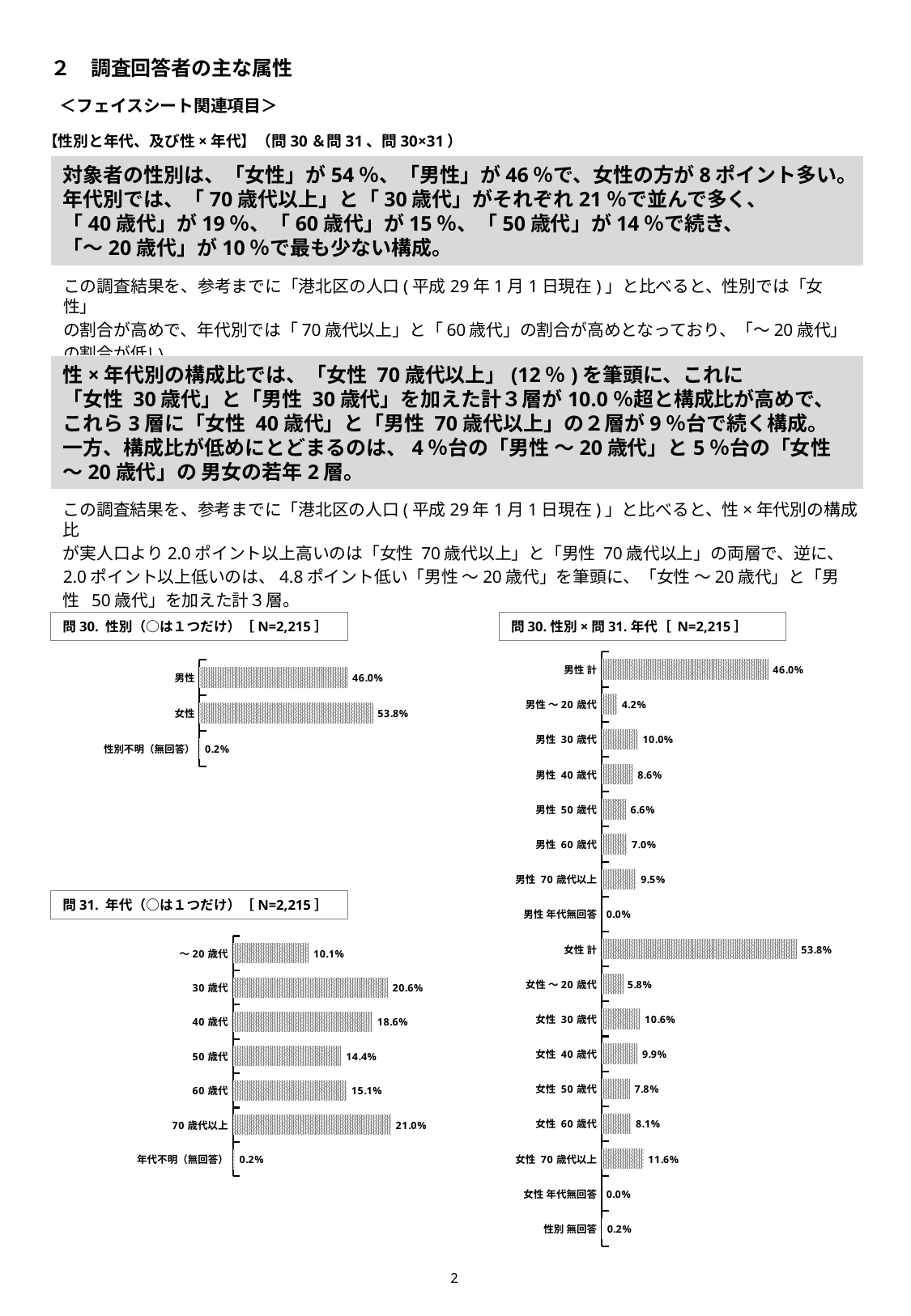
In the 問30. 性別 chart (top left), what is the value for 女性? 53.8% In the 問30. 性別 chart (top left), what is the value for 男性? 46.0% In the 問31. 年代 chart (bottom left), how many categories are plotted? 7 In the 問30. 性別 × 問31. 年代 chart (right), what is the difference between 女性 30歳代 and 男性 30歳代? 0.6 percentage points In the 問30. 性別 × 問31. 年代 chart (right), which is larger, 男性 40歳代 or 女性 40歳代? 女性 40歳代 In the 問31. 年代 chart (bottom left), which is larger, 50歳代 or 60歳代? 60歳代 In the 問31. 年代 chart (bottom left), which age category has the highest value? 70歳代以上 In the 問31. 年代 chart (bottom left), what is the value for 40歳代? 18.6% In the 問30. 性別 × 問31. 年代 chart (right), what is the value for 女性 70歳代以上? 11.6% In the 問30. 性別 × 問31. 年代 chart (right), what is the value for 男性 ～20歳代? 4.2% What type of chart is the 問31. 年代 chart (bottom left)? Bar chart In the 問30. 性別 chart (top left), what is the difference between 女性 and 男性? 7.8 percentage points